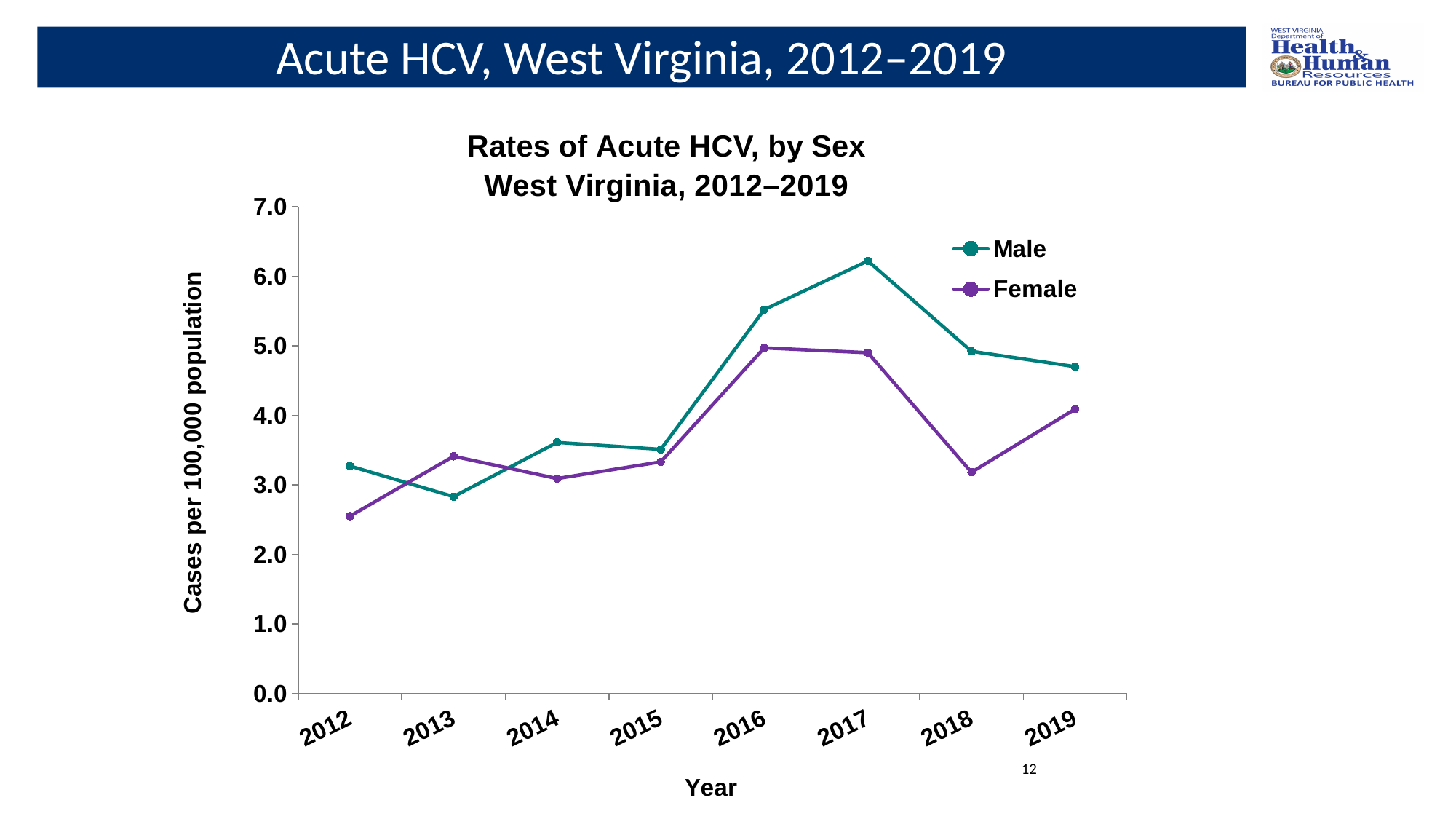
In 2017, which is higher, the Male rate or the Female rate? Male Is the Male rate for 2017 greater or less than 6.0? greater In which year is the Male rate lowest? 2013 In which year is the Female rate lowest? 2012 In which year is the Male rate highest? 2017 How many series does the legend list? 2 Is the Male rate for 2013 greater or less than 3.0? less In 2013, which is higher, the Male rate or the Female rate? Female How many years are plotted along the x axis? 8 Is the Female rate for 2018 greater or less than 3.0? greater What kind of chart is shown on the slide? line chart What is the label of the y axis? Cases per 100,000 population